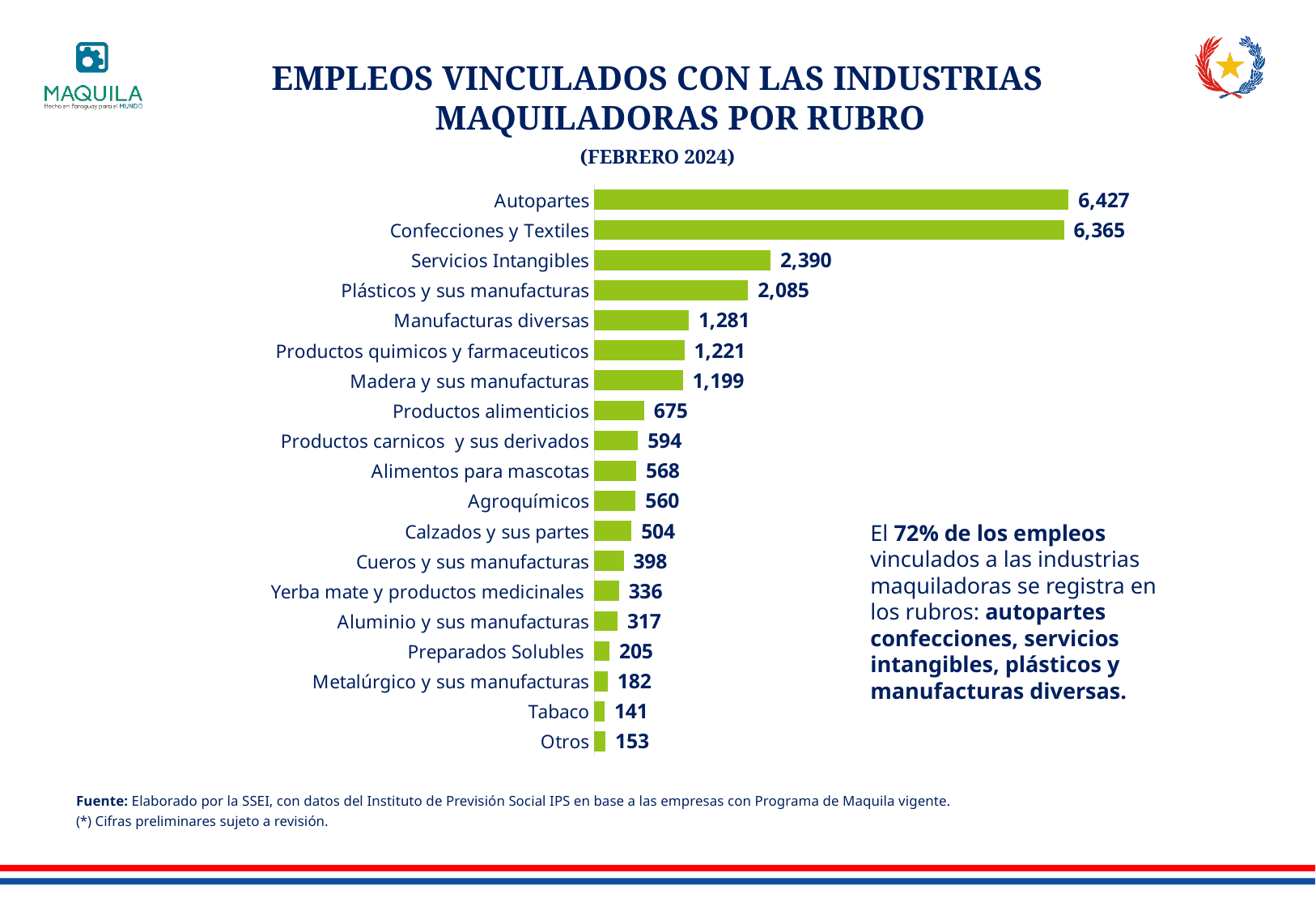
What kind of chart is shown on the slide? Bar chart What is the value for Preparados Solubles? 205 What is the difference between Servicios Intangibles and Plásticos y sus manufacturas? 305 What is the value for Madera y sus manufacturas? 1,199 Which category has the lowest value? Tabaco What period does the chart subtitle refer to? Febrero 2024 Which is larger, Productos alimenticios or Productos carnicos y sus derivados? Productos alimenticios Which category has the highest value? Autopartes How many categories are shown in the chart? 19 What is the value for Servicios Intangibles? 2,390 What is the difference between Autopartes and Confecciones y Textiles? 62 What is the value for Autopartes? 6,427